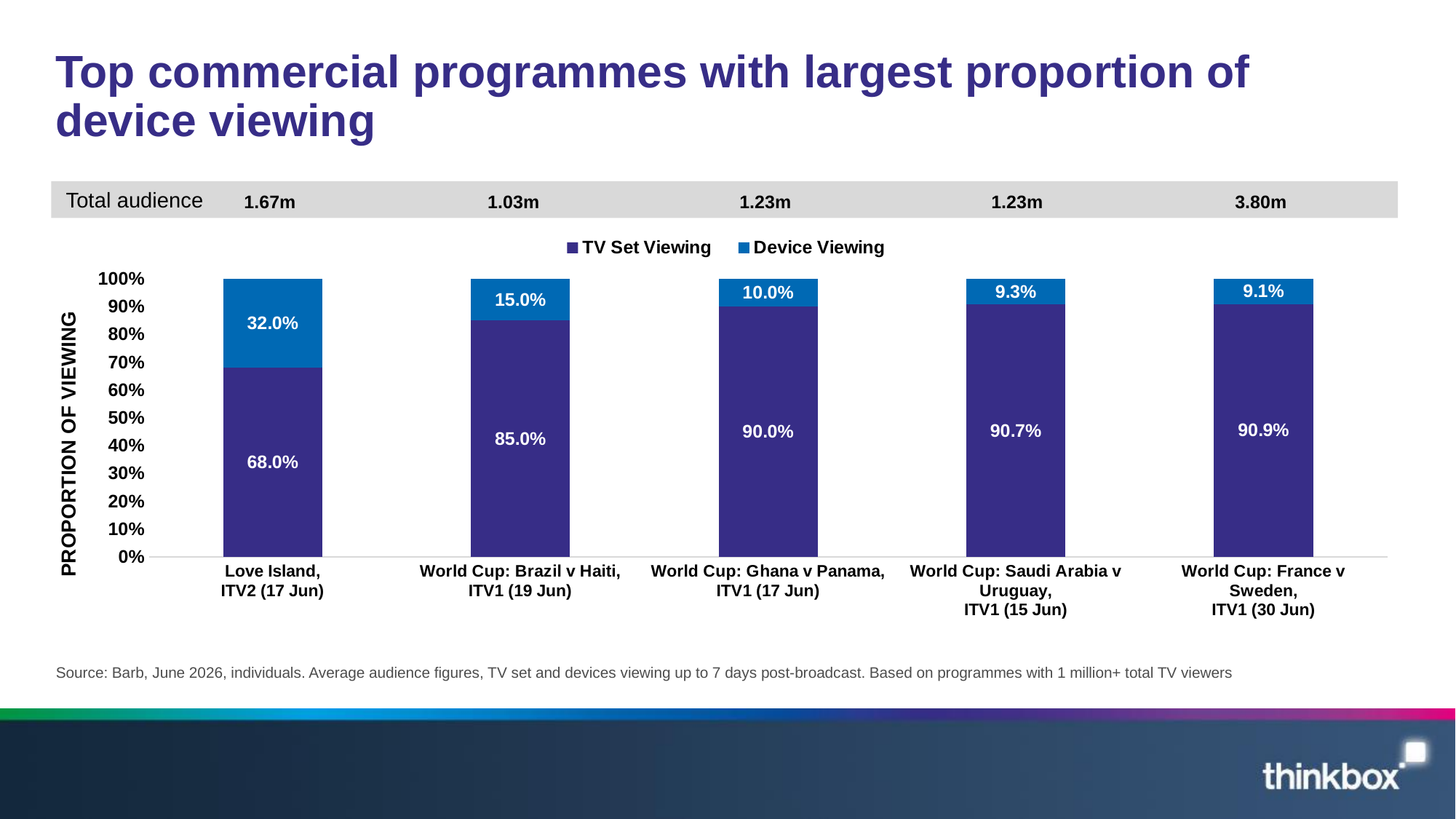
How many programmes are shown on the chart? 5 What is the Device Viewing value for World Cup: Saudi Arabia v Uruguay, ITV1 (15 Jun)? 9.3% What is the Device Viewing value for Love Island, ITV2 (17 Jun)? 32.0% What is the TV Set Viewing value for World Cup: Brazil v Haiti, ITV1 (19 Jun)? 85.0% How many series does the legend list? 2 Which programme has the lowest Device Viewing proportion? World Cup: France v Sweden, ITV1 (30 Jun) What is the label of the y axis? PROPORTION OF VIEWING What is the difference between the Device Viewing values for Love Island, ITV2 (17 Jun) and World Cup: Brazil v Haiti, ITV1 (19 Jun)? 17.0% Which programme has the highest Device Viewing proportion? Love Island, ITV2 (17 Jun) What kind of chart is shown on the slide? Stacked bar chart Which is larger: the TV Set Viewing value for World Cup: Ghana v Panama, ITV1 (17 Jun) or for World Cup: Brazil v Haiti, ITV1 (19 Jun)? World Cup: Ghana v Panama, ITV1 (17 Jun) What is the total audience shown for World Cup: France v Sweden, ITV1 (30 Jun)? 3.80m